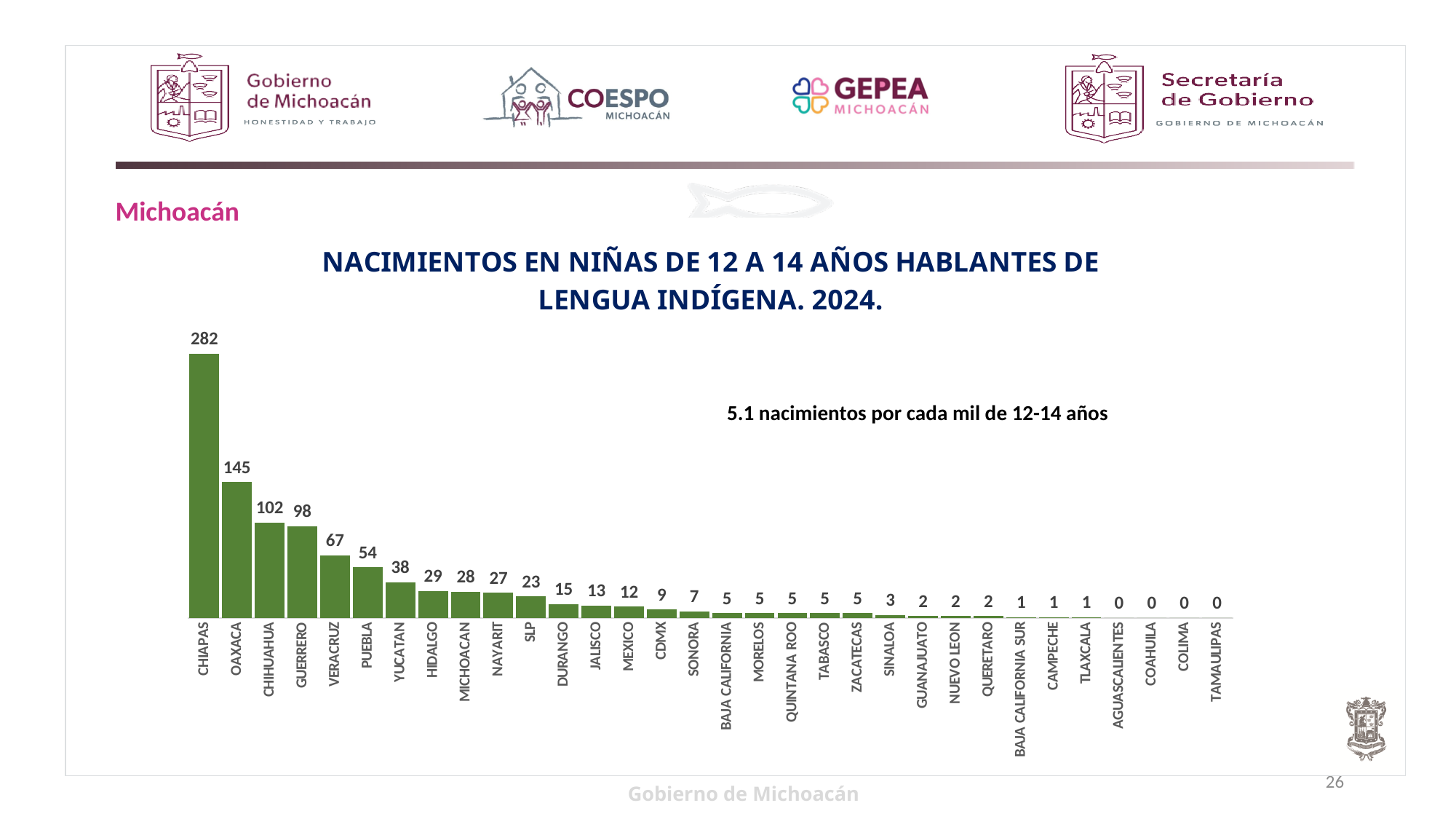
What is the title of the chart? NACIMIENTOS EN NIÑAS DE 12 A 14 AÑOS HABLANTES DE LENGUA INDÍGENA. 2024. Which state has the highest value? CHIAPAS What is the value for CHIAPAS? 282 How many states are shown on the chart? 32 What is the difference between the values for CHIHUAHUA and GUERRERO? 4 Which is larger, the value for PUEBLA or the value for YUCATAN? PUEBLA Which is larger, the value for DURANGO or the value for SLP? SLP What kind of chart is shown on the slide? Bar chart What is the difference between the values for CHIAPAS and OAXACA? 137 Do the values rise or fall from left to right along the x axis? Fall What is the value for MICHOACAN? 28 What is the value for VERACRUZ? 67